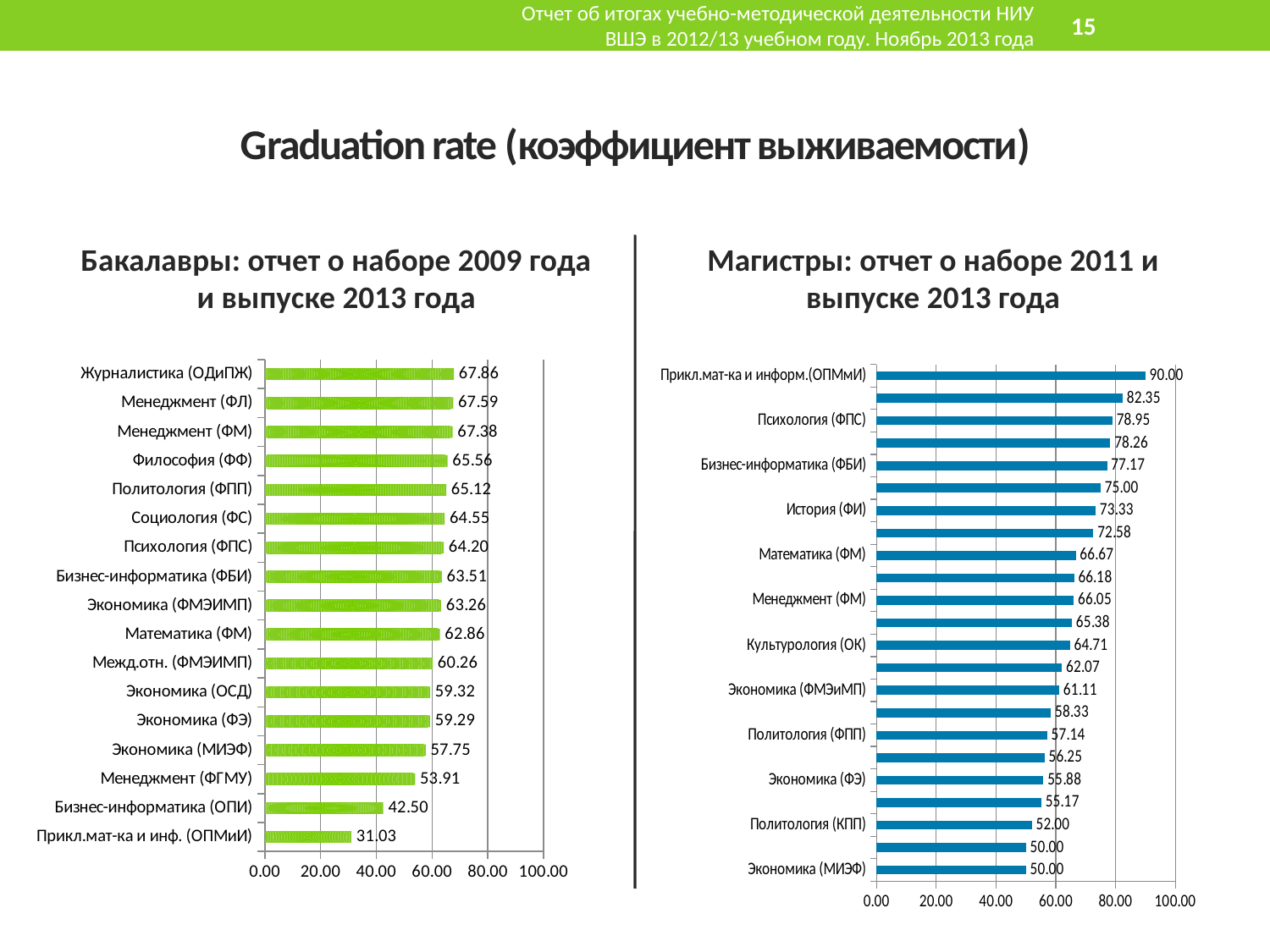
What type of chart is used on the left side of the slide (Бакалавры)? Bar chart In the left chart (Бакалавры), which category has the lowest value? Прикл.мат-ка и инф. (ОПМиИ) In the right chart (Магистры), what is the value for Экономика (МИЭФ)? 50.00 In the left chart (Бакалавры), which is larger: Социология (ФС) or Математика (ФМ)? Социология (ФС) In the right chart (Магистры), what is the value for Прикл.мат-ка и информ.(ОПМмИ)? 90.00 In the right chart (Магистры), which category has the highest value? Прикл.мат-ка и информ.(ОПМмИ) In the left chart (Бакалавры), what is the value for Бизнес-информатика (ОПИ)? 42.50 In the left chart (Бакалавры), how many categories are shown? 17 In the left chart (Бакалавры), what is the difference between Менеджмент (ФГМУ) and Бизнес-информатика (ОПИ)? 11.41 In the right chart (Магистры), is the value for Политология (КПП) greater or less than 60.00? less In the left chart (Бакалавры), what is the value for Журналистика (ОДиПЖ)? 67.86 In the right chart (Магистры), what is the difference between Психология (ФПС) and История (ФИ)? 5.62